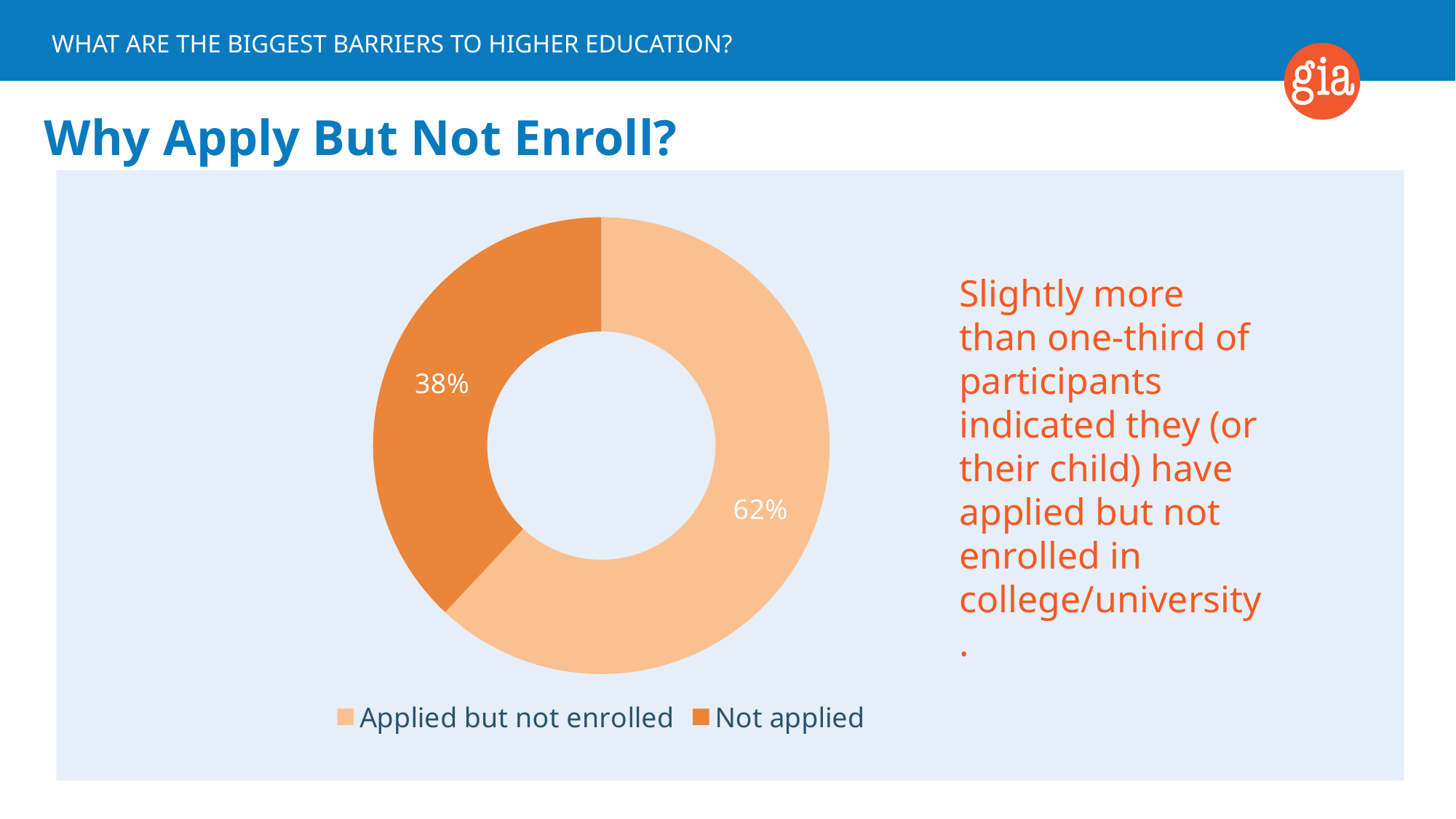
What share of the pie does the "Not applied" slice represent? 38% What is the difference in percentage points between the "Applied but not enrolled" slice and the "Not applied" slice? 24 What percentage of the pie chart is labelled "Applied but not enrolled"? 62% Which slice of the pie chart is the smallest? Not applied How many slices does the pie chart have? 2 Which slice of the pie chart is the largest? Applied but not enrolled Which legend entry is shown in the darker orange colour? Not applied What kind of chart is shown on the slide? Doughnut chart What percentage of the pie chart is labelled "Not applied"? 38% Which is larger: the "Applied but not enrolled" slice or the "Not applied" slice? Applied but not enrolled What is the title of the slide containing the chart? Why Apply But Not Enroll? How many entries does the chart legend list? 2